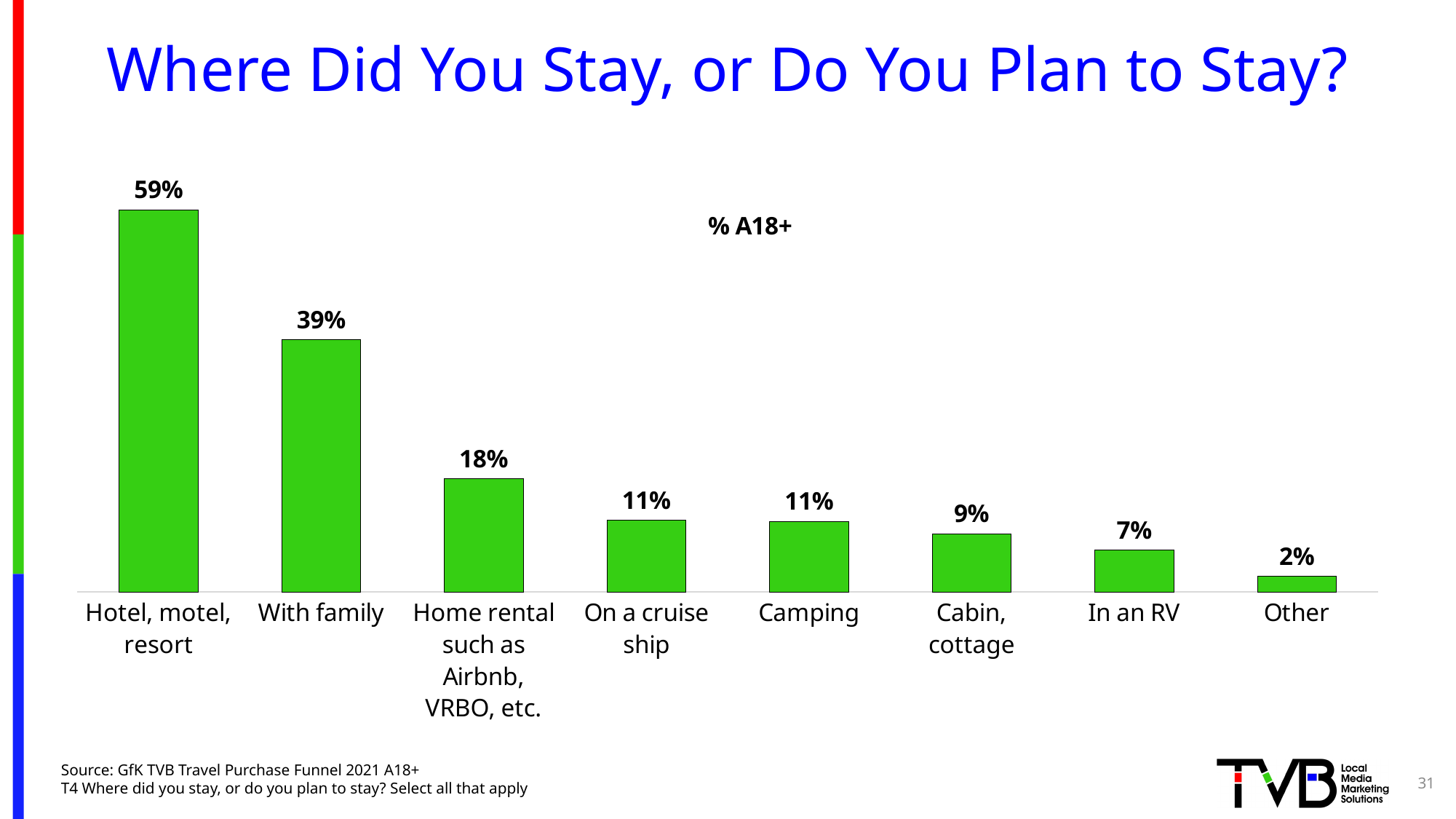
What is the difference between 'Hotel, motel, resort' and 'With family'? 20% What is the title of the chart? Where Did You Stay, or Do You Plan to Stay? Which category has the highest value? Hotel, motel, resort What percentage is shown for 'Home rental such as Airbnb, VRBO, etc.'? 18% Which is larger, 'Camping' or 'Cabin, cottage'? Camping What is the difference between 'Cabin, cottage' and 'Other'? 7% Which category has the lowest value? Other How many categories are shown in the chart? 8 What is the value for 'With family'? 39% What kind of chart is shown on the slide? Bar chart What is the value for 'In an RV'? 7% What percentage of respondents stayed or plan to stay at a hotel, motel, or resort? 59%